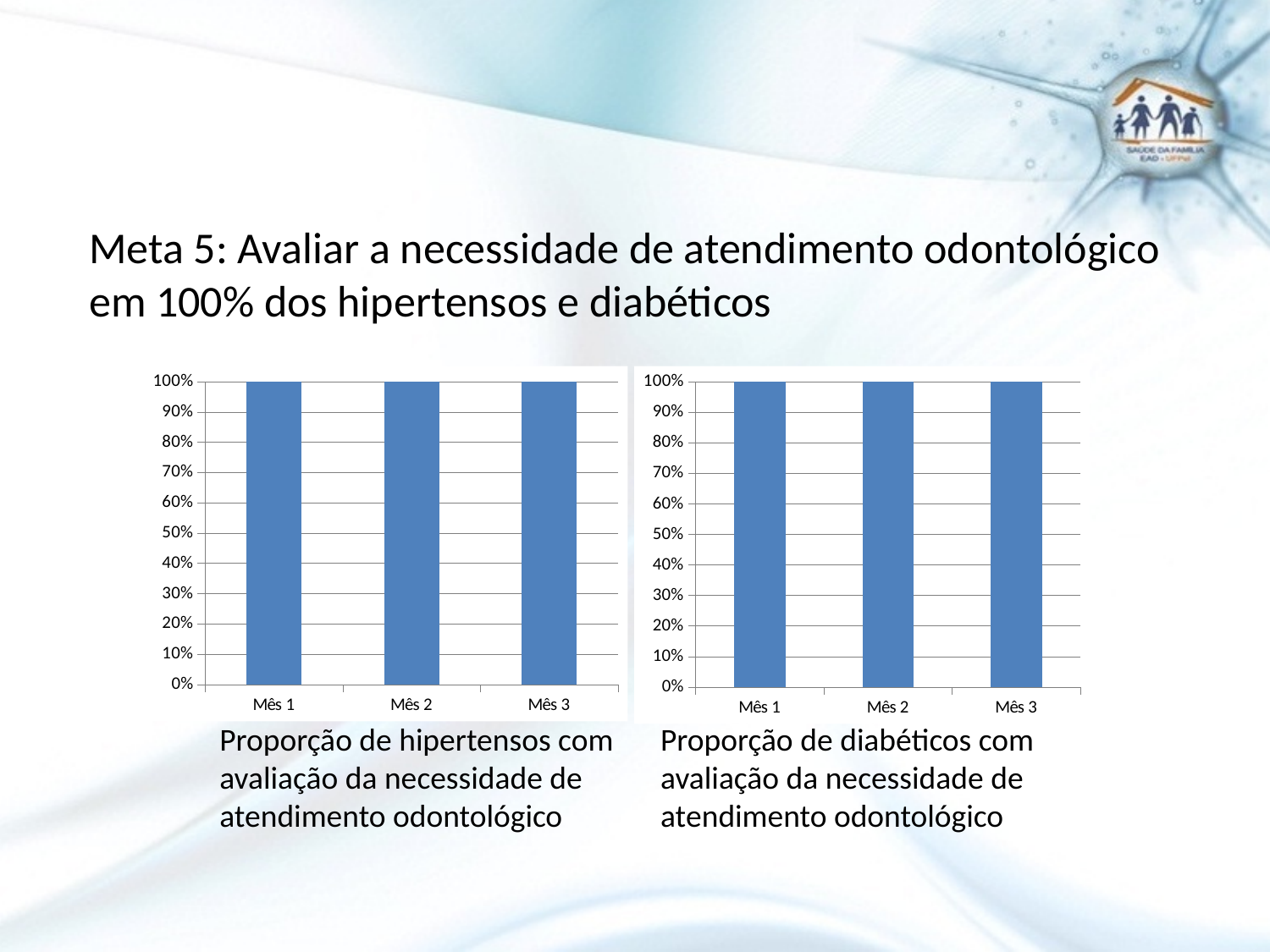
On the left chart (Proporção de hipertensos com avaliação da necessidade de atendimento odontológico), how many months are plotted? 3 On the left chart (Proporção de hipertensos com avaliação da necessidade de atendimento odontológico), is the value for Mês 2 greater or less than 50%? greater On the left chart (Proporção de hipertensos com avaliação da necessidade de atendimento odontológico), what is the value for Mês 3? 100% What type of chart is the right chart (Proporção de diabéticos com avaliação da necessidade de atendimento odontológico)? Bar chart On the right chart (Proporção de diabéticos com avaliação da necessidade de atendimento odontológico), how many bars are there? 3 What type of chart is the left chart (Proporção de hipertensos com avaliação da necessidade de atendimento odontológico)? Bar chart On the right chart (Proporção de diabéticos com avaliação da necessidade de atendimento odontológico), what is the value for Mês 2? 100% On the right chart (Proporção de diabéticos com avaliação da necessidade de atendimento odontológico), what is the difference between the values for Mês 1 and Mês 3? 0% On the left chart (Proporção de hipertensos com avaliação da necessidade de atendimento odontológico), do the values rise, fall or stay the same from Mês 1 to Mês 3? Stay the same On the right chart (Proporção de diabéticos com avaliação da necessidade de atendimento odontológico), what is the value for Mês 3? 100% On the left chart (Proporção de hipertensos com avaliação da necessidade de atendimento odontológico), what is the value for Mês 1? 100% What is the caption of the right chart on the slide? Proporção de diabéticos com avaliação da necessidade de atendimento odontológico